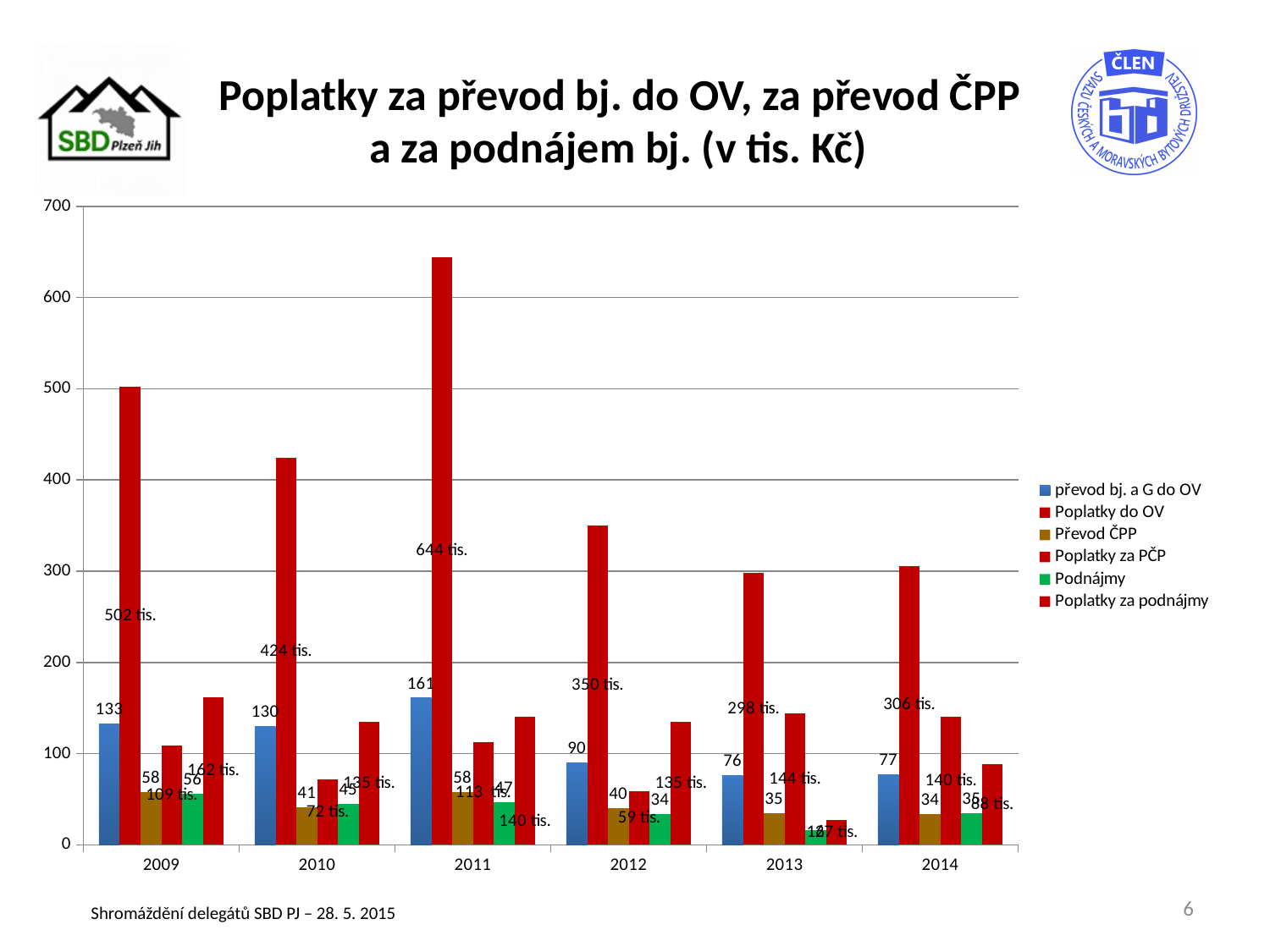
What is the value of Převod ČPP for 2010? 41 What is the title of the chart on the slide? Poplatky za převod bj. do OV, za převod ČPP a za podnájem bj. (v tis. Kč) What kind of chart is shown on the slide? bar chart How many years are shown on the x axis of the chart? 6 What is the value of Poplatky do OV for 2011? 644 tis. Which year has the larger value for převod bj. a G do OV, 2011 or 2012? 2011 What is the difference between Poplatky do OV in 2009 and in 2010? 78 tis. What is the value of převod bj. a G do OV for 2009? 133 In which year is Poplatky do OV the highest? 2011 Does Poplatky do OV rise or fall from 2011 to 2013? fall Is the value of Poplatky do OV for 2012 greater or less than 300? greater How many series does the chart legend list? 6